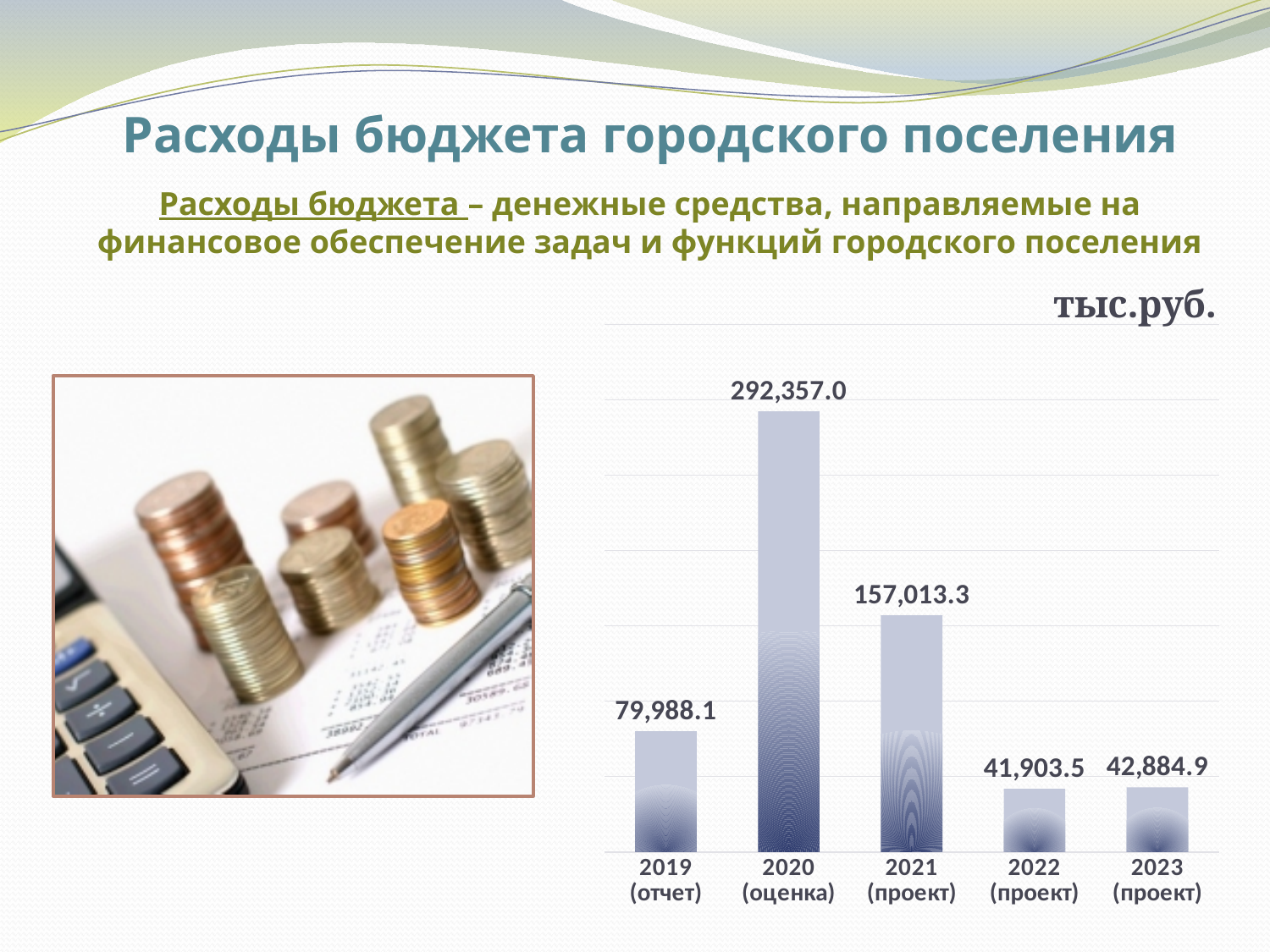
Which year has the lowest budget expenditure? 2022 (проект) What is the difference between the values for 2020 (оценка) and 2021 (проект)? 135,343.7 Which is larger, the value for 2019 (отчет) or the value for 2021 (проект)? 2021 (проект) What is the difference between the values for 2023 (проект) and 2022 (проект)? 981.4 What type of chart is shown on the slide? Bar chart How many years (categories) are shown in the chart? 5 In what units are the chart values expressed? тыс.руб. Which year has the highest budget expenditure? 2020 (оценка) What is the budget expenditure value for 2020 (оценка)? 292,357.0 What is the value shown for 2021 (проект)? 157,013.3 What is the value shown for 2019 (отчет)? 79,988.1 What is the value shown for 2023 (проект)? 42,884.9